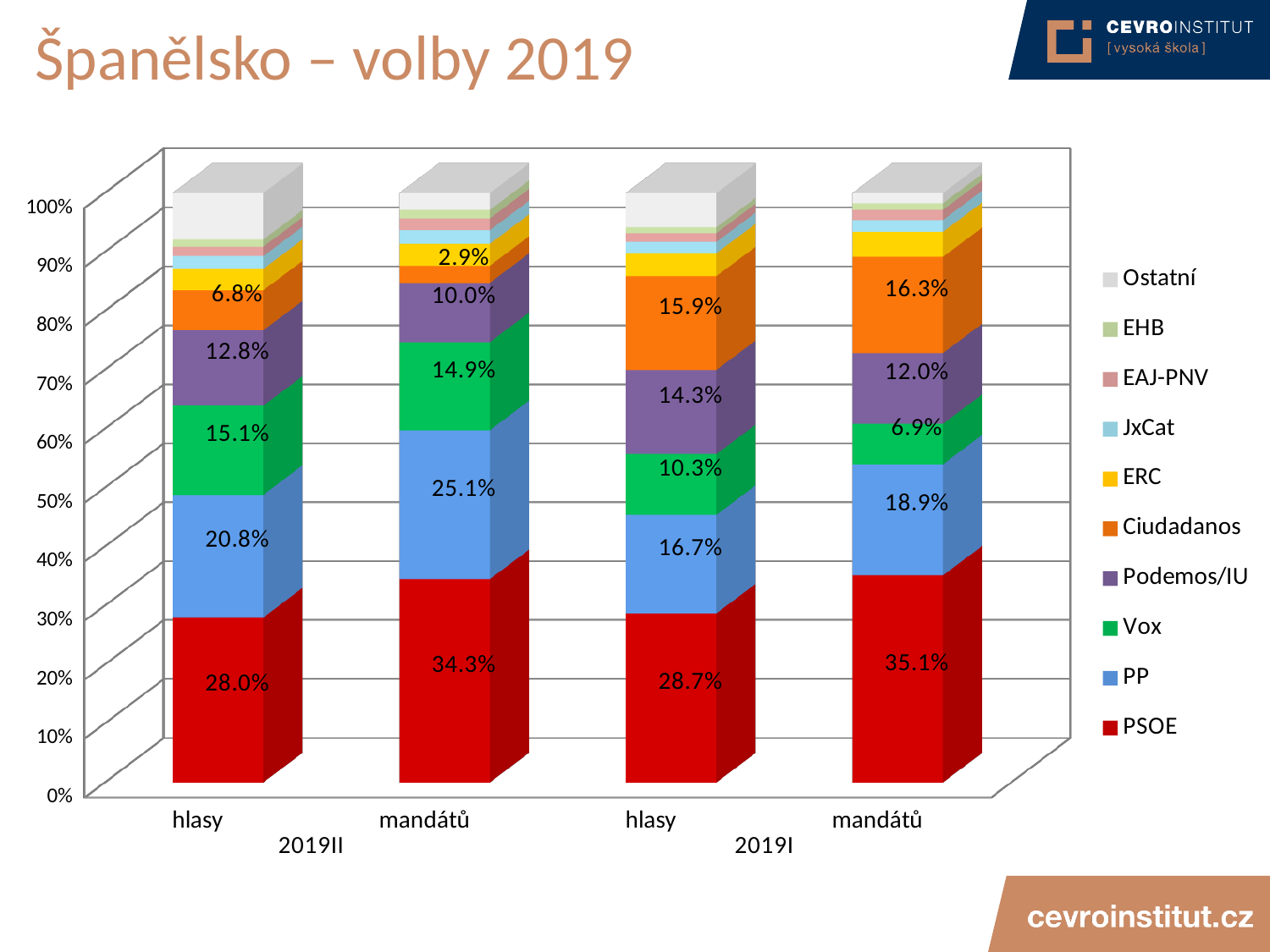
In which bar does Vox have its lowest share? mandátů 2019I (6.9%) What share does PSOE have in the 'hlasy' bar for 2019II? 28.0% What share does Vox have in the 'mandátů' bar for 2019I? 6.9% What share does PP have in the 'mandátů' bar for 2019II? 25.1% What share does Ciudadanos have in the 'hlasy' bar for 2019I? 15.9% How many bars are plotted on the chart? 4 How many series does the legend list? 10 In which bar does PSOE have its highest share? mandátů 2019I (35.1%) Is Vox's share larger in 'hlasy' 2019II or in 'hlasy' 2019I? hlasy 2019II How much larger is PSOE's share in 'mandátů' 2019II than in 'hlasy' 2019II? 6.3 percentage points What share does Podemos/IU have in the 'hlasy' bar for 2019I? 14.3% What kind of chart is shown on the slide? Stacked bar chart